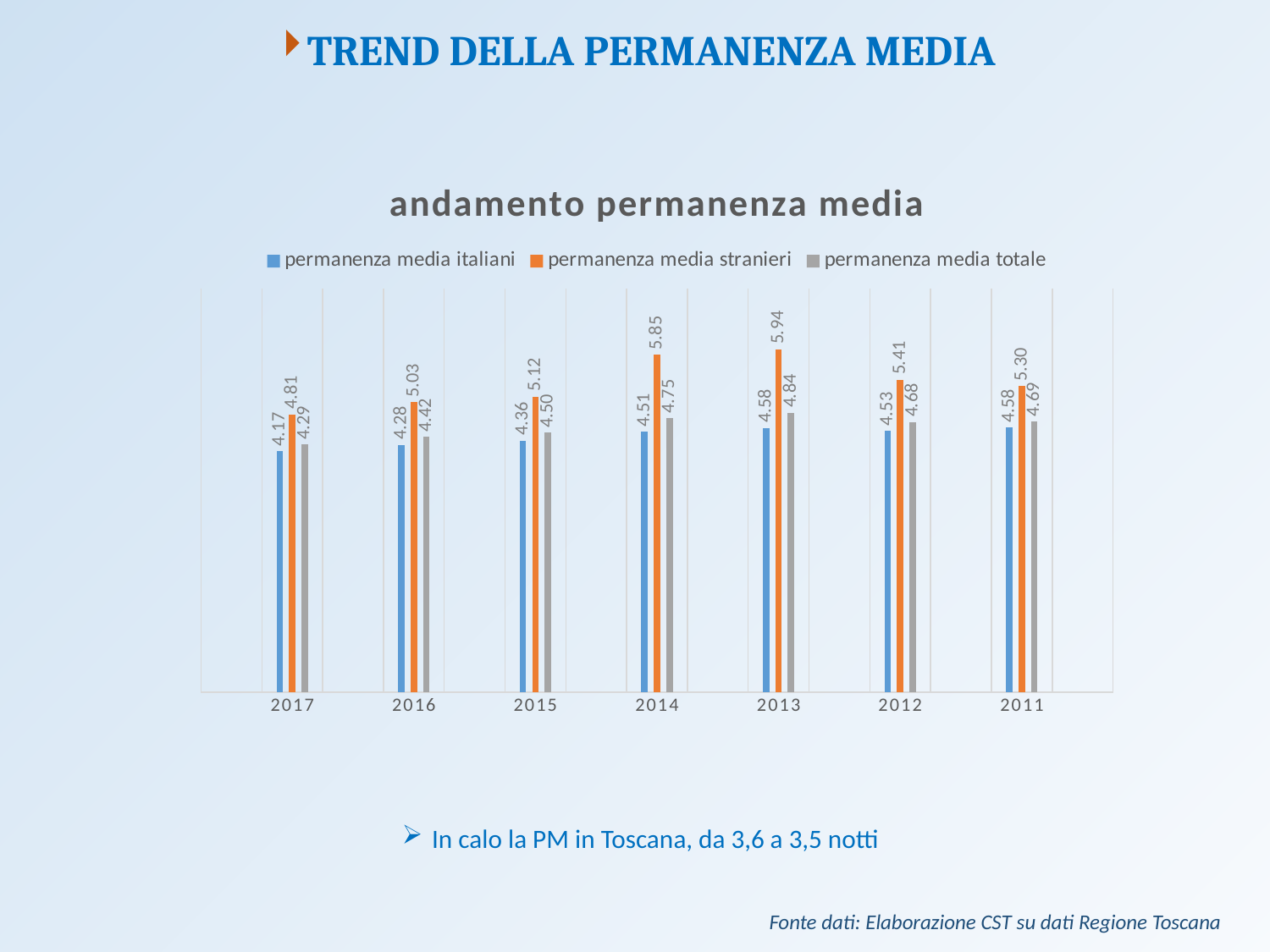
Which is larger in 2016: permanenza media totale or permanenza media italiani? permanenza media totale What is the value of permanenza media italiani for 2017? 4.17 What kind of chart is shown on the slide? bar chart How many series does the legend list? 3 In which year is permanenza media stranieri highest? 2013 What is the value of permanenza media totale for 2014? 4.75 How many years are shown on the x axis? 7 In which year is permanenza media italiani lowest? 2017 What is the value of permanenza media stranieri for 2013? 5.94 What is the title of the chart? andamento permanenza media What is the difference between permanenza media stranieri and permanenza media italiani in 2014? 1.34 Which colour represents permanenza media stranieri in the chart? orange